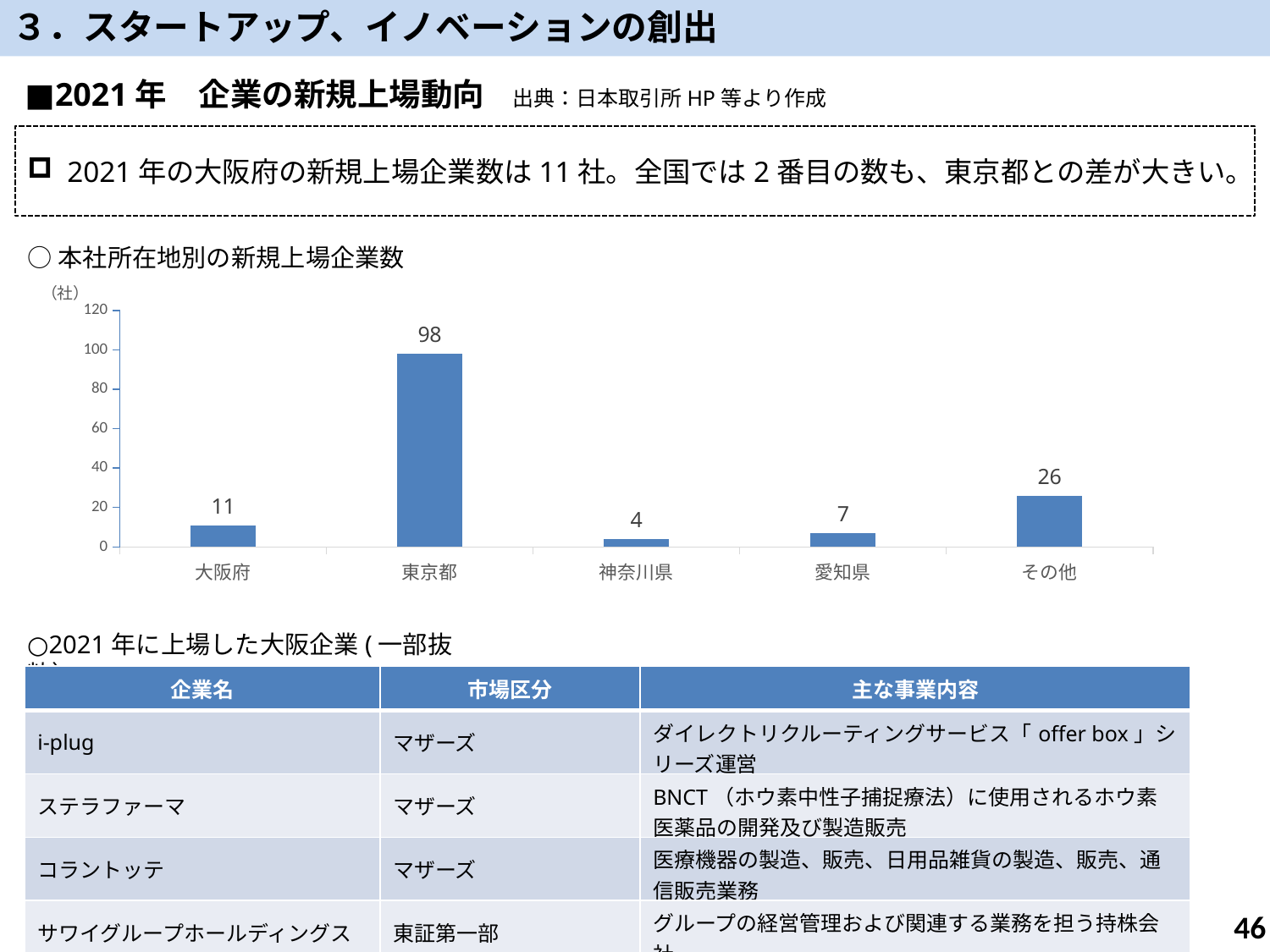
What unit is shown at the top of the y axis of the chart? （社） What is the value for 神奈川県 in the chart? 4 What is the value for 愛知県 in the chart? 7 What is the value for 東京都 in the chart? 98 How many categories are shown on the x axis of the chart? 5 What is the difference between the values for 東京都 and 大阪府? 87 What is the value for その他 in the chart? 26 What kind of chart is shown on the slide? Bar chart Which category has the highest value in the chart? 東京都 What is the value for 大阪府 in the 本社所在地別の新規上場企業数 chart? 11 Which is larger, the value for その他 or the value for 大阪府? その他 Which category has the lowest value in the chart? 神奈川県